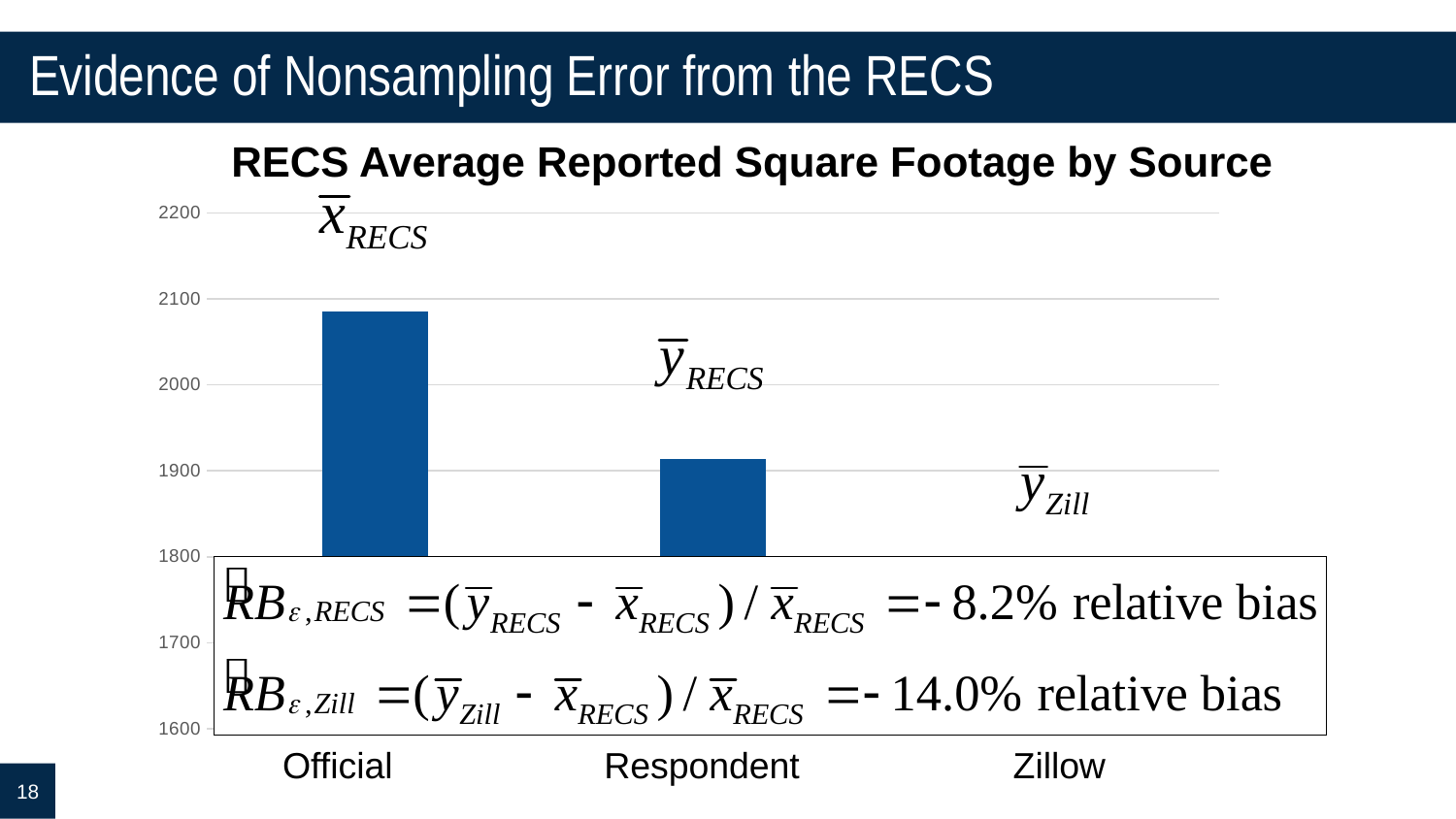
Is the value for Respondent greater or less than 2000? less How many categories are shown on the x axis of the chart? 3 Which is larger, the value for Official or the value for Respondent? Official What is the lowest value shown on the y axis of the chart? 1600 Is the value for Official greater or less than 2000? greater Is the value for Respondent greater or less than 1900? greater Which category has the highest average reported square footage? Official What is the title of the chart? RECS Average Reported Square Footage by Source What kind of chart is shown on the slide? bar chart